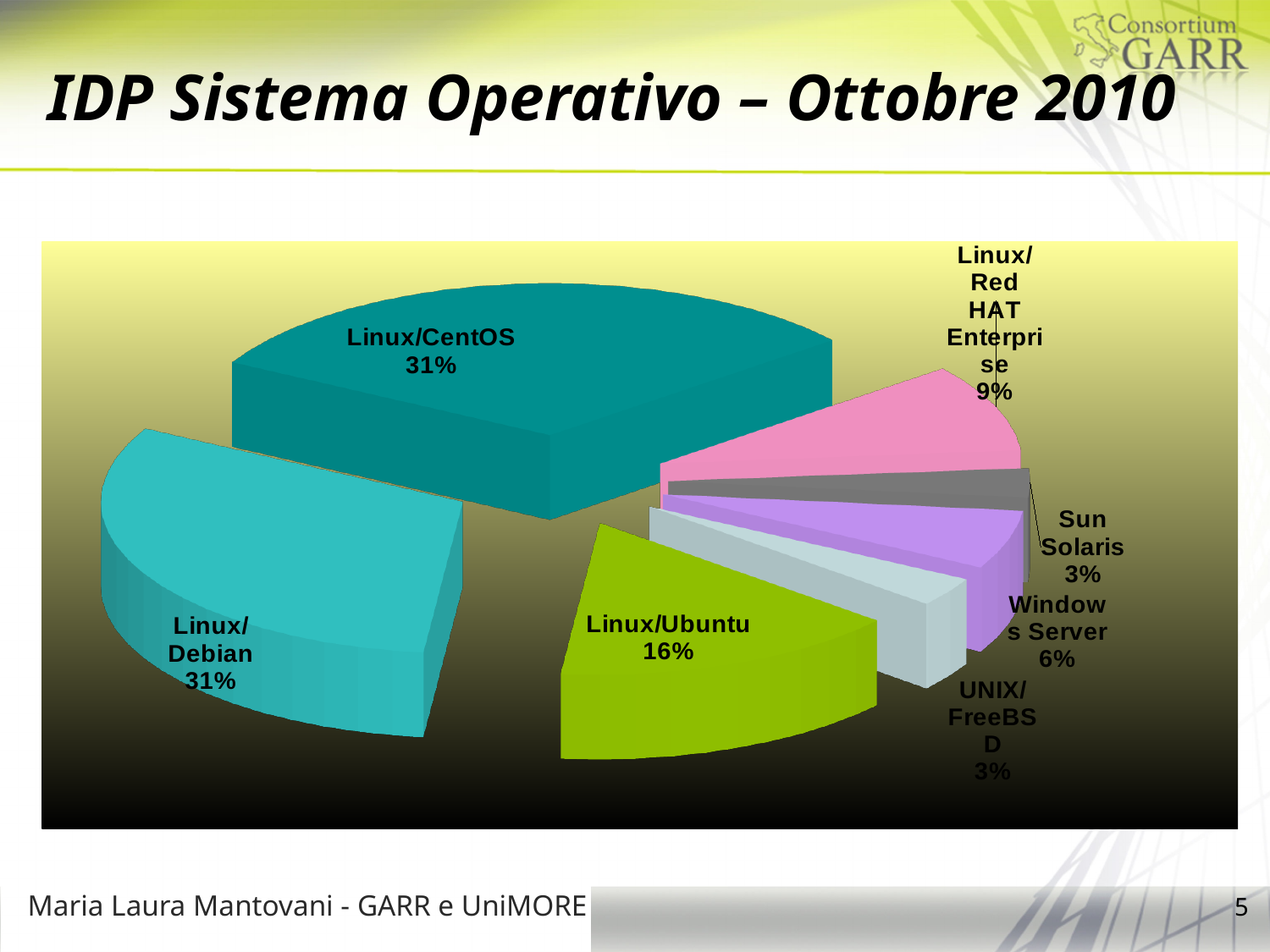
What is the value shown for Windows Server? 6% What is the difference between the Linux/Ubuntu and Linux/Red HAT Enterprise shares? 7% What share of the pie does Linux/Ubuntu represent? 16% What is the value shown for Sun Solaris? 3% What kind of chart is shown on the slide? pie chart What is the value shown for Linux/CentOS? 31% What is the difference between the Windows Server and UNIX/FreeBSD shares? 3% Which is larger, Linux/Ubuntu or Linux/Red HAT Enterprise? Linux/Ubuntu How many slices does the pie chart have? 7 What share of the pie does Linux/Debian represent? 31% What is the value shown for Linux/Red HAT Enterprise? 9% What is the title of the slide containing the chart? IDP Sistema Operativo – Ottobre 2010